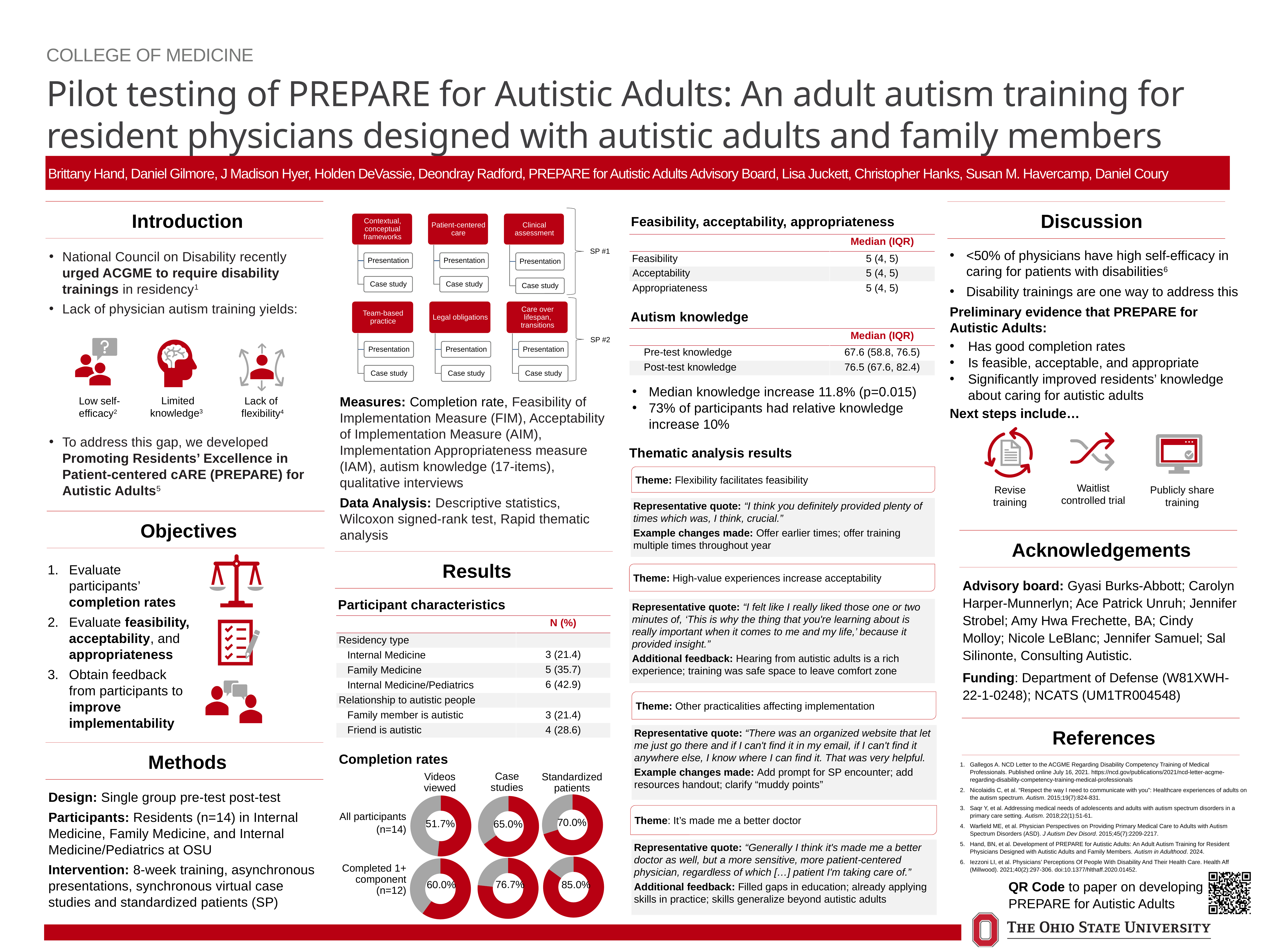
In the Completion rates charts, what is the completion rate for Standardized patients among All participants (n=14)? 70.0% In the Completion rates charts, what is the completion rate for Videos viewed among All participants (n=14)? 51.7% How many donut charts are shown in the Completion rates section? 6 In the Completion rates charts, which component has the lowest completion rate among All participants (n=14)? Videos viewed In the Completion rates charts, which component has the highest completion rate among those who Completed 1+ component (n=12)? Standardized patients In the Completion rates charts, what is the completion rate for Standardized patients among those who Completed 1+ component (n=12)? 85.0% In the Completion rates charts, what is the completion rate for Videos viewed among those who Completed 1+ component (n=12)? 60.0% In the Completion rates charts, what is the difference between the Standardized patients completion rate for Completed 1+ component (n=12) and for All participants (n=14)? 15.0% In the Completion rates charts, what is the completion rate for Case studies among All participants (n=14)? 65.0% What type of chart is used to show the Completion rates? Donut (pie) chart In the Completion rates charts, what is the completion rate for Case studies among those who Completed 1+ component (n=12)? 76.7% In the Completion rates charts, which is larger: the Case studies completion rate for All participants (n=14) or for Completed 1+ component (n=12)? Completed 1+ component (n=12)